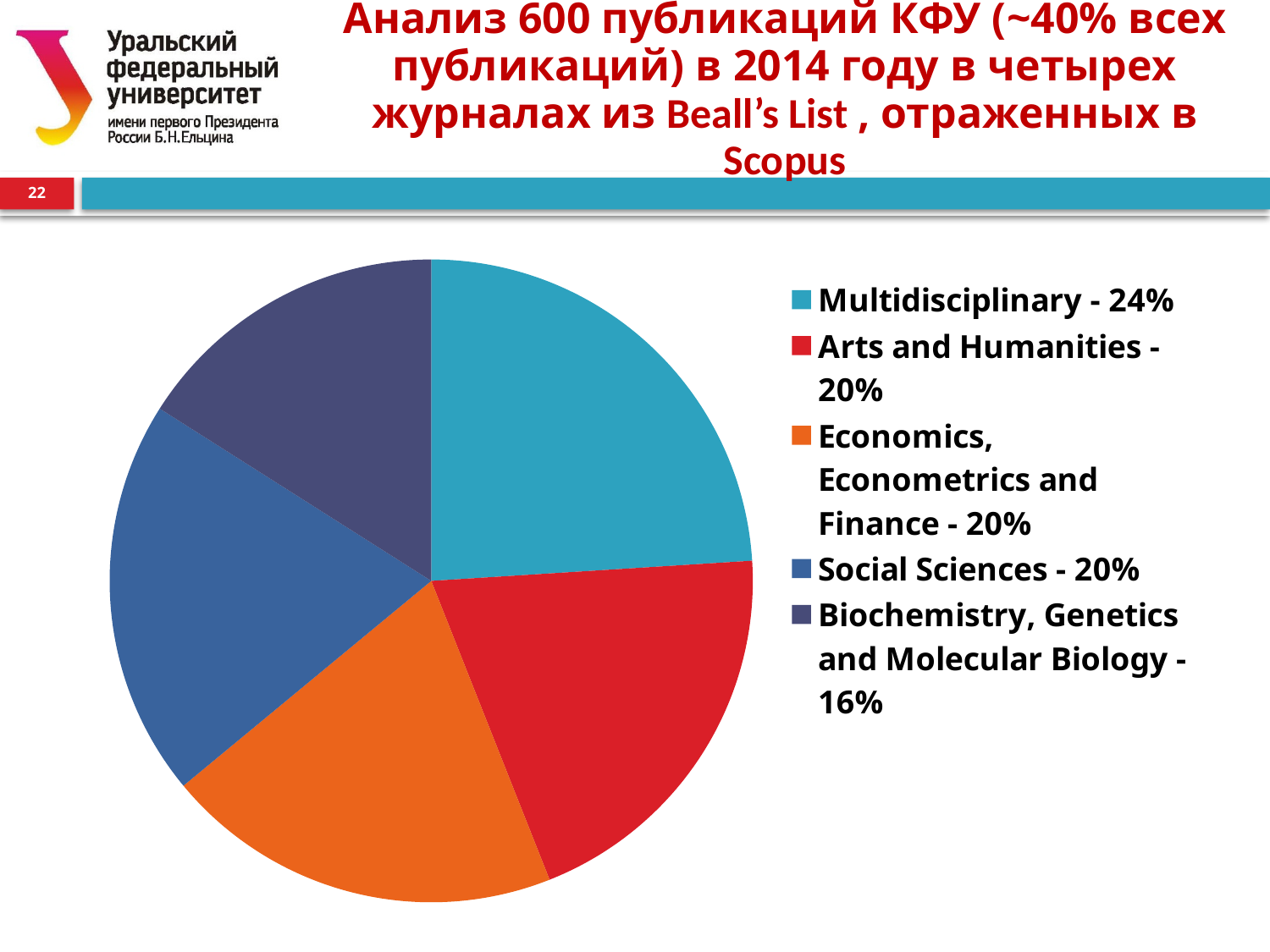
What share of the pie does Multidisciplinary account for? 24% According to the slide title, how many KFU publications were analysed? 600 What is the value shown for Social Sciences? 20% What kind of chart is shown on the slide? pie chart What is the difference in percentage points between Multidisciplinary and Biochemistry, Genetics and Molecular Biology? 8 Which is larger: the share for Multidisciplinary or the share for Economics, Econometrics and Finance? Multidisciplinary What is the value shown for Biochemistry, Genetics and Molecular Biology? 16% Which category has the smallest share of the pie? Biochemistry, Genetics and Molecular Biology How many categories does the pie chart show? 5 Which category has the largest share of the pie? Multidisciplinary What is the value shown for Arts and Humanities? 20% What colour is the Multidisciplinary slice of the pie? teal (light blue)